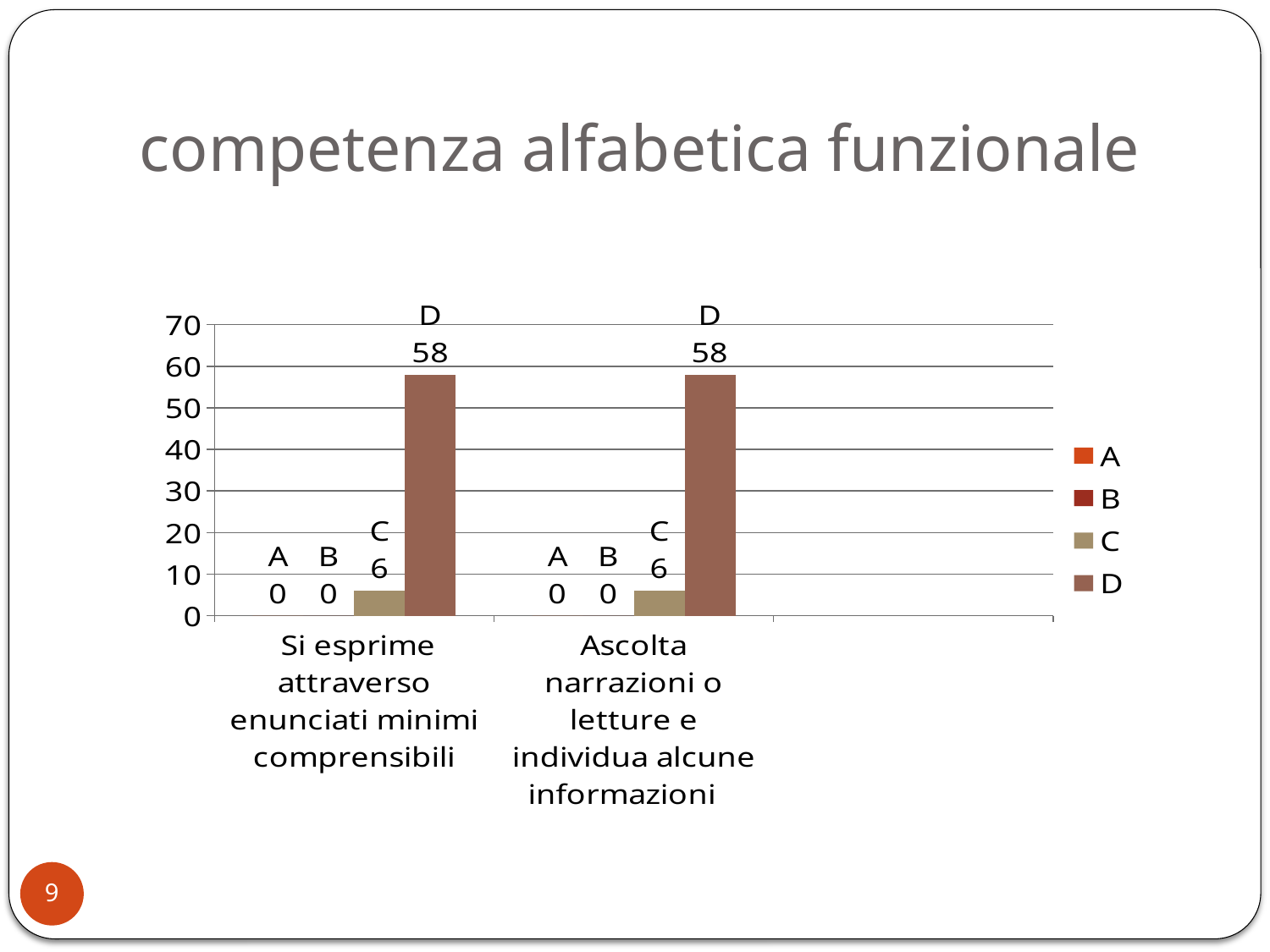
Which series has the highest value in the category "Ascolta narrazioni o letture e individua alcune informazioni"? D Which is larger in the category "Ascolta narrazioni o letture e individua alcune informazioni": the value for series C or the value for series D? D Is the value for series D in the category "Si esprime attraverso enunciati minimi comprensibili" greater or less than 50? greater What kind of chart is shown on the slide? bar chart What is the value for series D in the category "Si esprime attraverso enunciati minimi comprensibili"? 58 What is the value for series A in the category "Si esprime attraverso enunciati minimi comprensibili"? 0 How many categories are shown on the x axis of the chart? 2 What is the value for series C in the category "Ascolta narrazioni o letture e individua alcune informazioni"? 6 What is the title of the slide containing the chart? competenza alfabetica funzionale What is the difference between the values for series D and series C in the category "Si esprime attraverso enunciati minimi comprensibili"? 52 What is the value for series B in the category "Ascolta narrazioni o letture e individua alcune informazioni"? 0 How many series does the legend list? 4